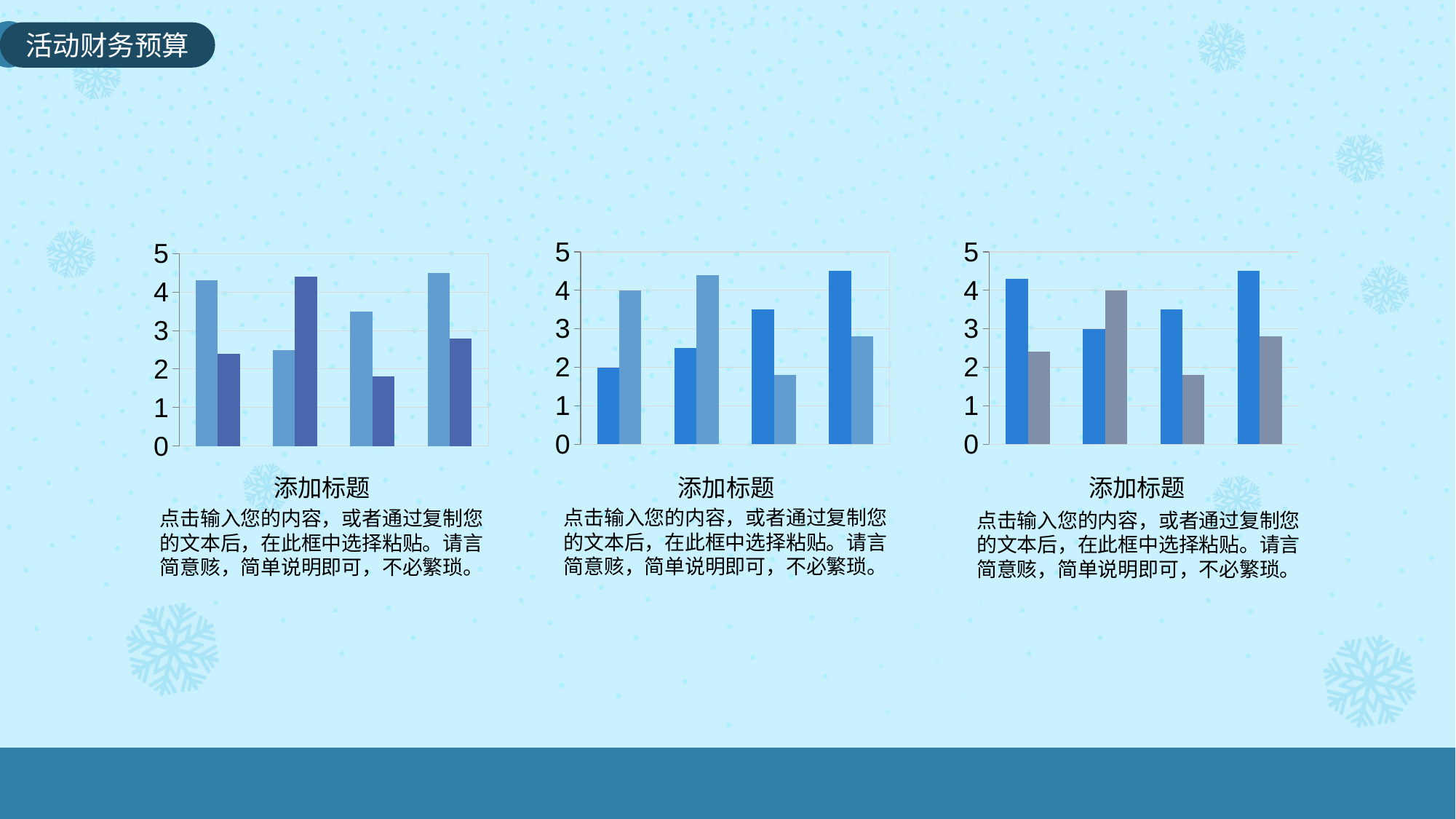
How many groups of bars does the middle chart show? 4 How many groups of bars does the right chart show? 4 In the middle chart, is the value of the light blue bar in the second group from the left greater or less than 4? greater In the left chart, is the light blue bar or the dark blue bar taller in the second group from the left? the dark blue bar In the right chart, is the blue bar or the grey bar taller in the first group from the left? the blue bar What is the highest value shown on the vertical axis of the middle chart? 5 In the middle chart, is the value of the dark blue bar in the first group from the left greater or less than 3? less In the right chart, is the value of the blue bar in the fourth group from the left greater or less than 4? greater What kind of chart is the left chart on the slide? bar chart